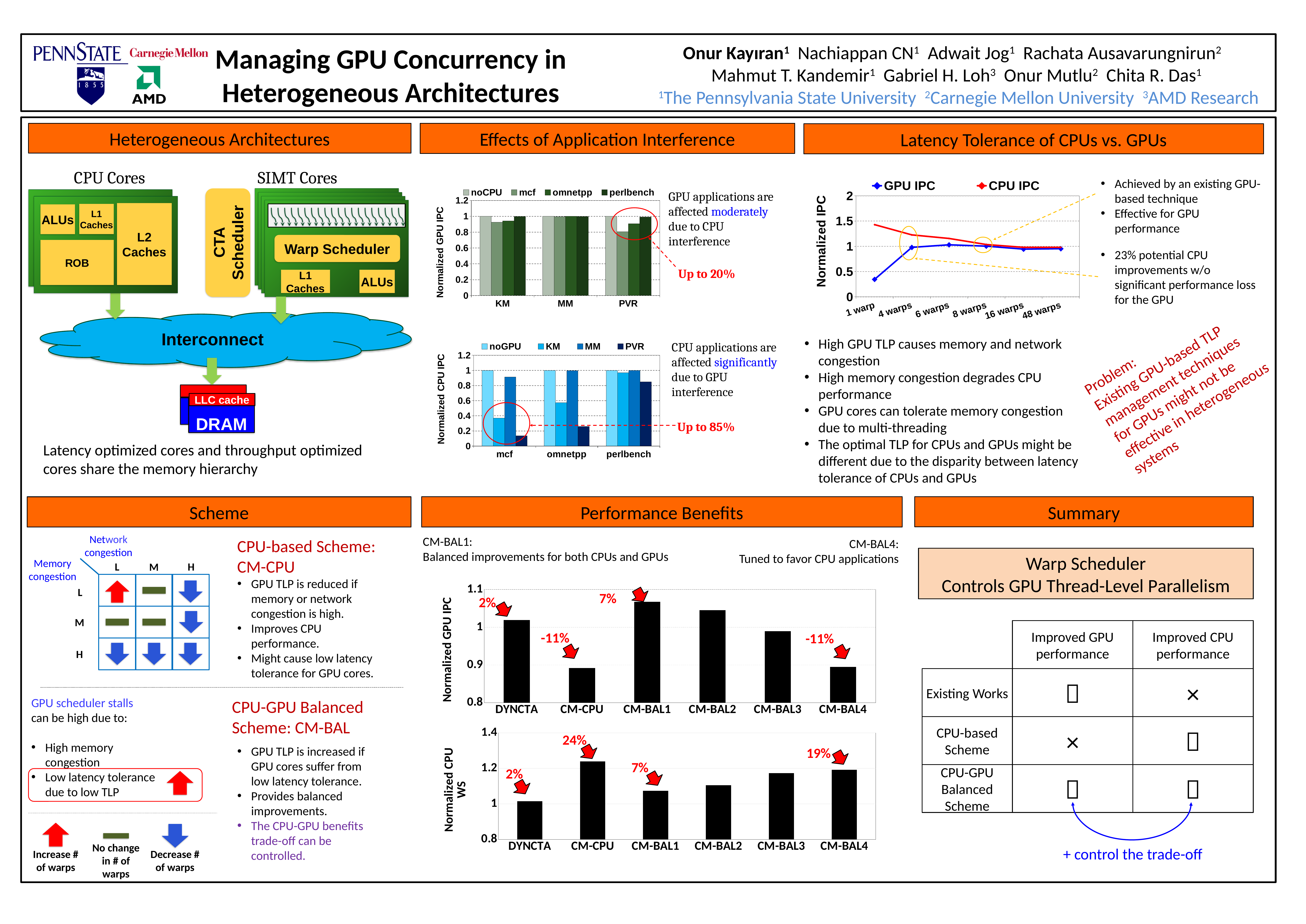
In the Normalized CPU IPC chart under 'Effects of Application Interference', for mcf, which is larger: the KM bar or the MM bar? MM In the Normalized CPU WS chart under 'Performance Benefits', what percentage is annotated above the CM-BAL4 bar? 19% In the Normalized CPU WS chart under 'Performance Benefits', which category has the lowest value? DYNCTA In the Normalized CPU IPC chart under 'Effects of Application Interference', how many categories are on the x axis? 3 In the Normalized GPU IPC chart under 'Effects of Application Interference', how many series does the legend list? 4 In the Normalized IPC chart under 'Latency Tolerance of CPUs vs. GPUs', is the GPU IPC value at 1 warp greater or less than 0.5? less In the Normalized GPU IPC chart under 'Performance Benefits', is the value for CM-BAL1 greater or less than 1? greater In the Normalized GPU IPC chart under 'Performance Benefits', how many categories are on the x axis? 6 What kind of chart is the Normalized IPC chart under 'Latency Tolerance of CPUs vs. GPUs'? line chart In the Normalized CPU WS chart under 'Performance Benefits', which category has the highest value? CM-CPU In the Normalized IPC chart under 'Latency Tolerance of CPUs vs. GPUs', how many points are on the x axis? 6 In the Normalized IPC chart under 'Latency Tolerance of CPUs vs. GPUs', does the CPU IPC line rise or fall from 1 warp to 48 warps? fall